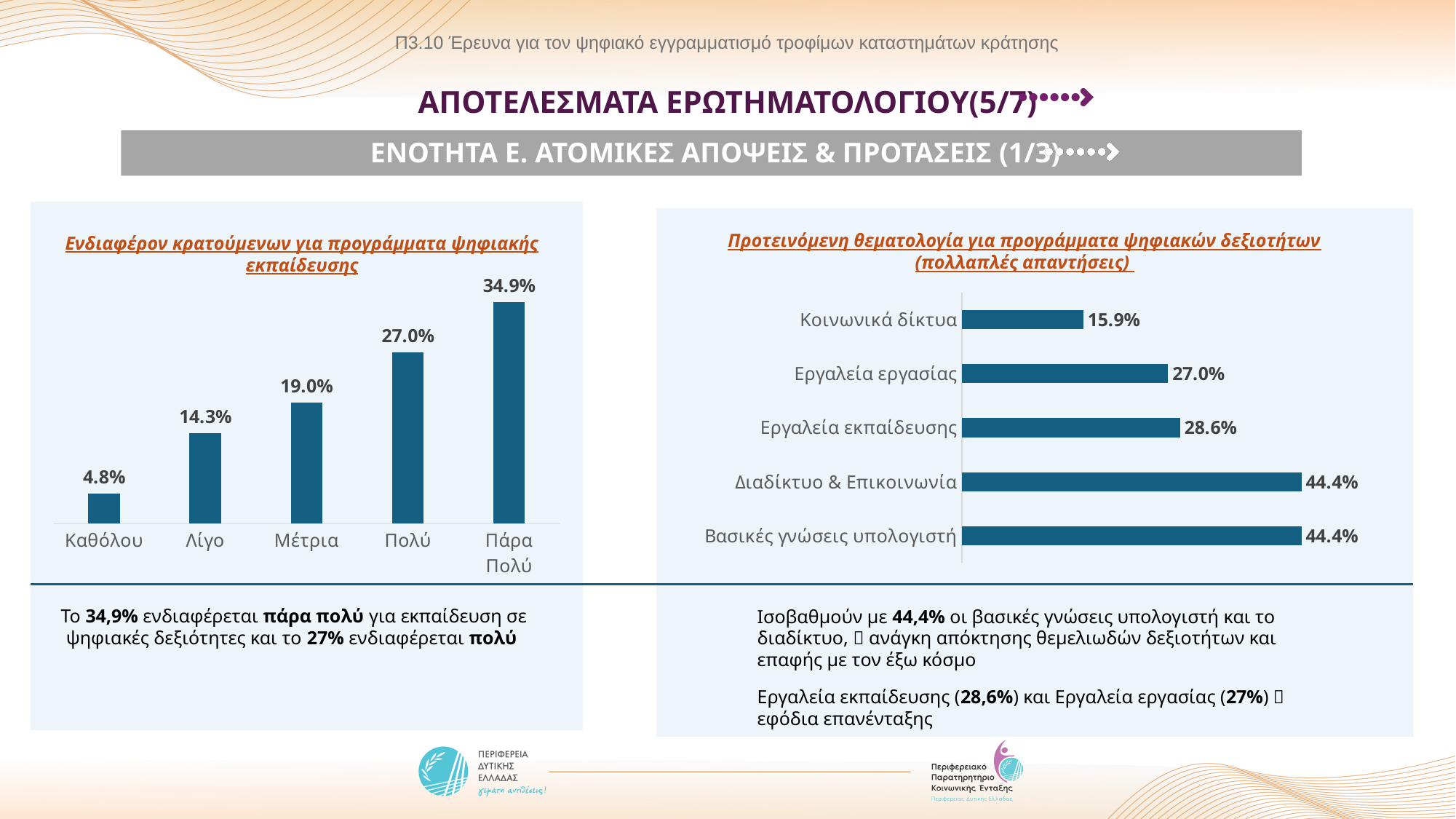
In the left chart (Ενδιαφέρον κρατούμενων για προγράμματα ψηφιακής εκπαίδευσης), what is the difference between Πολύ and Λίγο? 12.7% What kind of chart is the right chart (Προτεινόμενη θεματολογία για προγράμματα ψηφιακών δεξιοτήτων)? bar chart In the right chart (Προτεινόμενη θεματολογία για προγράμματα ψηφιακών δεξιοτήτων), which is larger: Εργαλεία εργασίας or Διαδίκτυο & Επικοινωνία? Διαδίκτυο & Επικοινωνία In the left chart (Ενδιαφέρον κρατούμενων για προγράμματα ψηφιακής εκπαίδευσης), which category has the highest value? Πάρα Πολύ In the left chart (Ενδιαφέρον κρατούμενων για προγράμματα ψηφιακής εκπαίδευσης), do the values rise or fall from Καθόλου to Πάρα Πολύ? rise In the right chart (Προτεινόμενη θεματολογία για προγράμματα ψηφιακών δεξιοτήτων), what is the difference between Βασικές γνώσεις υπολογιστή and Κοινωνικά δίκτυα? 28.5% In the right chart (Προτεινόμενη θεματολογία για προγράμματα ψηφιακών δεξιοτήτων), which category has the lowest value? Κοινωνικά δίκτυα In the left chart (Ενδιαφέρον κρατούμενων για προγράμματα ψηφιακής εκπαίδευσης), what is the value for Πάρα Πολύ? 34.9% How many categories are shown in the left chart (Ενδιαφέρον κρατούμενων για προγράμματα ψηφιακής εκπαίδευσης)? 5 In the right chart (Προτεινόμενη θεματολογία για προγράμματα ψηφιακών δεξιοτήτων), what is the value for Εργαλεία εκπαίδευσης? 28.6% In the left chart (Ενδιαφέρον κρατούμενων για προγράμματα ψηφιακής εκπαίδευσης), what is the value for Μέτρια? 19.0% In the left chart (Ενδιαφέρον κρατούμενων για προγράμματα ψηφιακής εκπαίδευσης), which category has the lowest value? Καθόλου